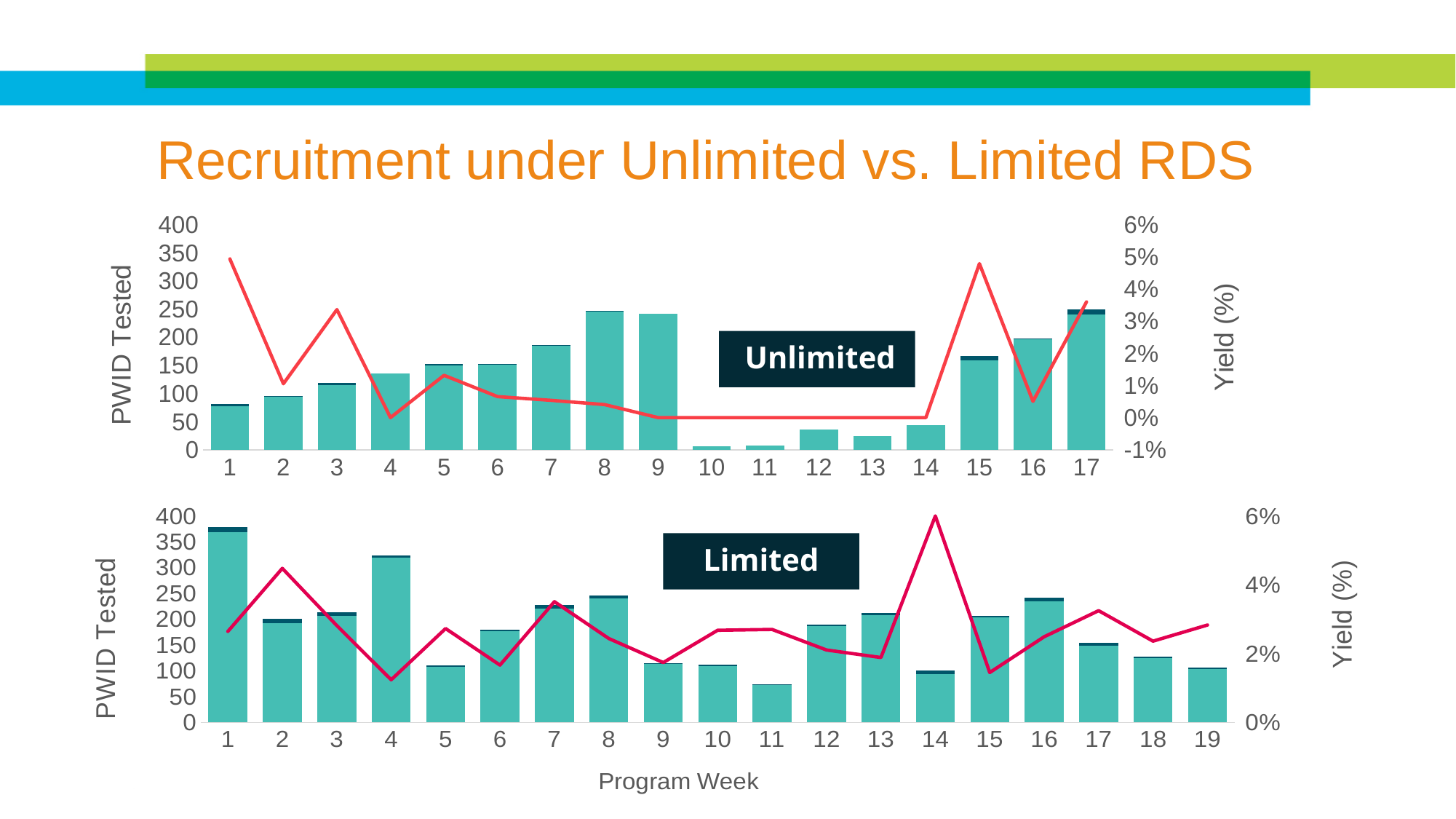
In the Limited chart, in which week does the yield line reach its peak? Week 14 What is the label of the right-hand vertical axis on both charts? Yield (%) In the Limited chart, which week has the highest number of PWID tested? Week 1 In the Unlimited chart, which week has more PWID tested, week 3 or week 7? Week 7 How many program weeks are shown on the x axis of the Limited chart? 19 In the Limited chart, do the PWID Tested bars rise or fall from week 16 to week 19? fall In the Unlimited chart, is the PWID Tested value for week 4 greater or less than 150? less In the Limited chart, is the PWID Tested value for week 4 greater or less than 300? greater What kind of chart is used for the Unlimited and Limited panels? Bar chart with a line In the Unlimited chart, is the PWID Tested value for week 8 greater or less than 200? greater How many program weeks are shown on the x axis of the Unlimited chart? 17 In the Limited chart, which week has the lowest number of PWID tested? Week 11